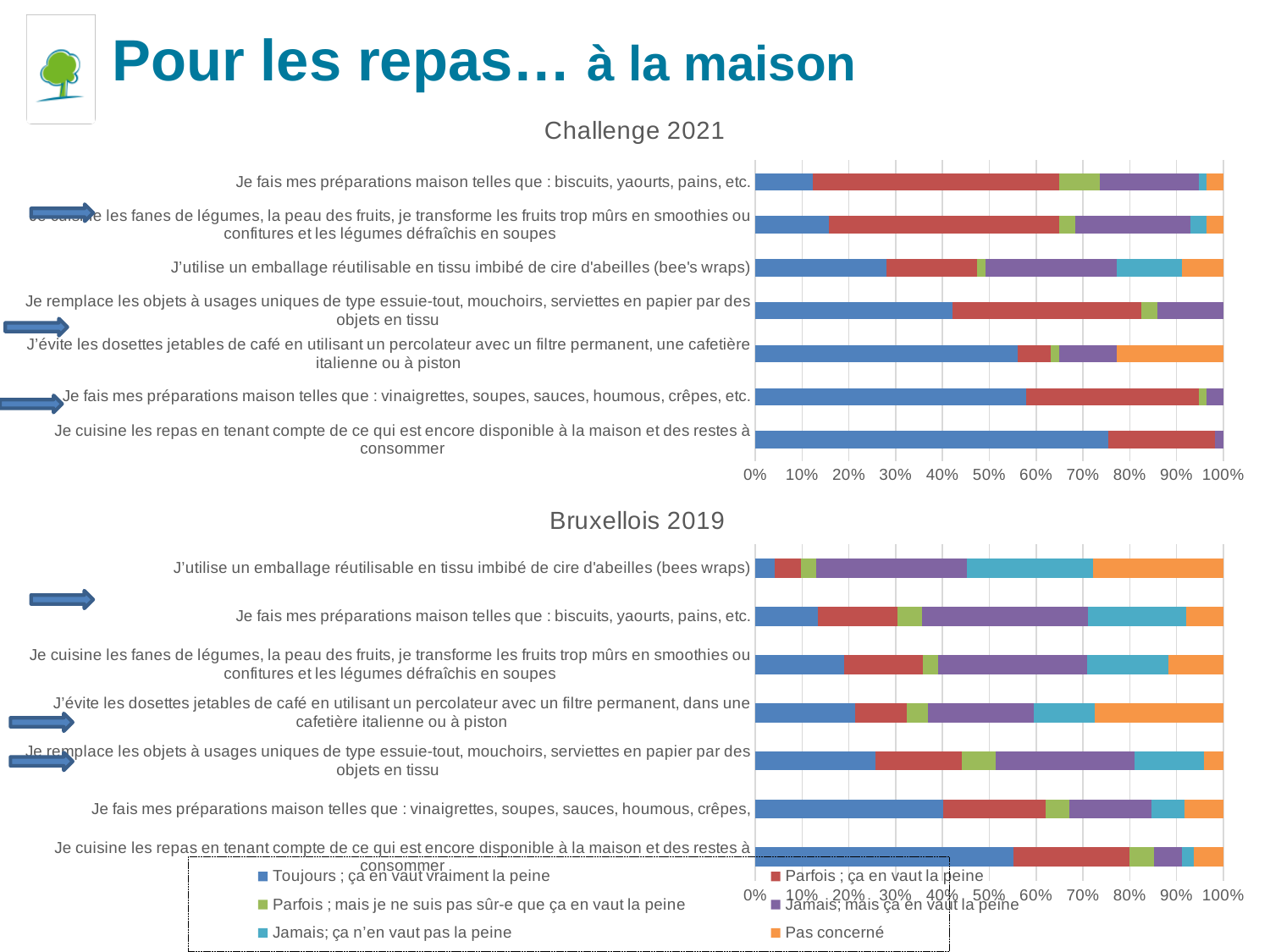
How many categories (statements) are shown in the 'Bruxellois 2019' chart? 7 In the 'Challenge 2021' chart, which has the larger 'Pas concerné' segment: 'J'évite les dosettes jetables de café...' or 'Je fais mes préparations maison telles que : biscuits, yaourts, pains, etc.'? J'évite les dosettes jetables de café... In the 'Challenge 2021' chart, is the 'Toujours ; ça en vaut vraiment la peine' share for 'Je cuisine les repas en tenant compte de ce qui est encore disponible à la maison et des restes à consommer' greater or less than 70%? greater In the 'Challenge 2021' chart, which statement has the largest 'Toujours ; ça en vaut vraiment la peine' segment? Je cuisine les repas en tenant compte de ce qui est encore disponible à la maison et des restes à consommer In the 'Bruxellois 2019' chart, which statement has the largest 'Toujours ; ça en vaut vraiment la peine' segment? Je cuisine les repas en tenant compte de ce qui est encore disponible à la maison et des restes à consommer How many series does the legend list? 6 In the 'Challenge 2021' chart, is the 'Toujours ; ça en vaut vraiment la peine' share for 'Je fais mes préparations maison telles que : biscuits, yaourts, pains, etc.' greater or less than 20%? less In the 'Bruxellois 2019' chart, which statement has the smallest 'Toujours ; ça en vaut vraiment la peine' segment? J'utilise un emballage réutilisable en tissu imbibé de cire d'abeilles (bees wraps) Which legend entry is shown in orange? Pas concerné What kind of chart is the 'Challenge 2021' chart? Stacked bar chart In the 'Bruxellois 2019' chart, is the 'Toujours ; ça en vaut vraiment la peine' share for 'J'utilise un emballage réutilisable en tissu imbibé de cire d'abeilles (bees wraps)' greater or less than 10%? less